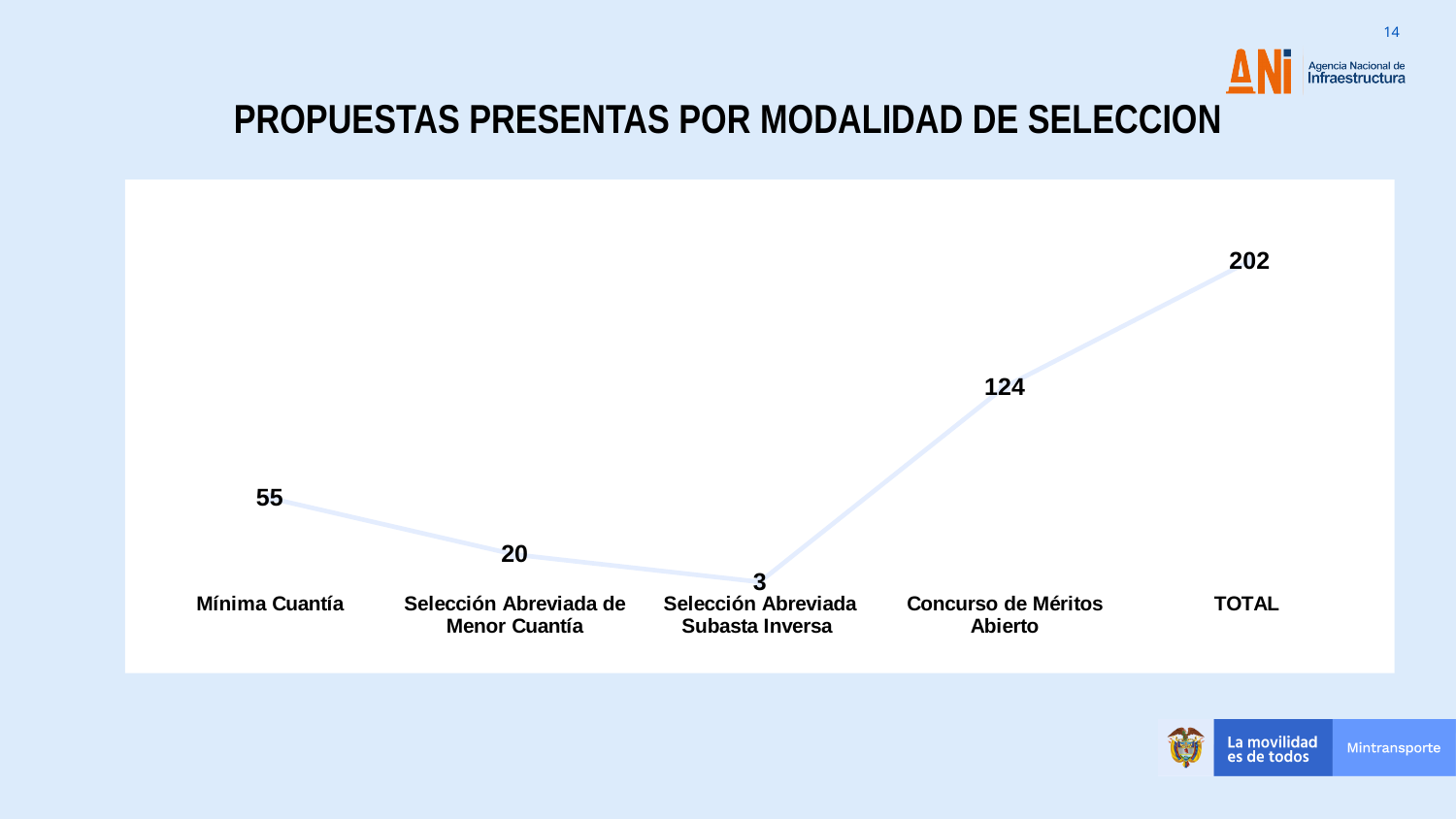
What is the value for Selección Abreviada de Menor Cuantía? 20 What is the value for Concurso de Méritos Abierto? 124 Excluding TOTAL, which category has the highest value? Concurso de Méritos Abierto Which category has the lowest value? Selección Abreviada Subasta Inversa What kind of chart is shown on the slide? Line chart What is the value for Selección Abreviada Subasta Inversa? 3 What is the value shown for TOTAL? 202 What is the title of the chart? PROPUESTAS PRESENTAS POR MODALIDAD DE SELECCION What is the difference between the values for Concurso de Méritos Abierto and Mínima Cuantía? 69 Which is larger, the value for Mínima Cuantía or the value for Selección Abreviada de Menor Cuantía? Mínima Cuantía How many categories are plotted on the x axis? 5 What is the value for Mínima Cuantía? 55